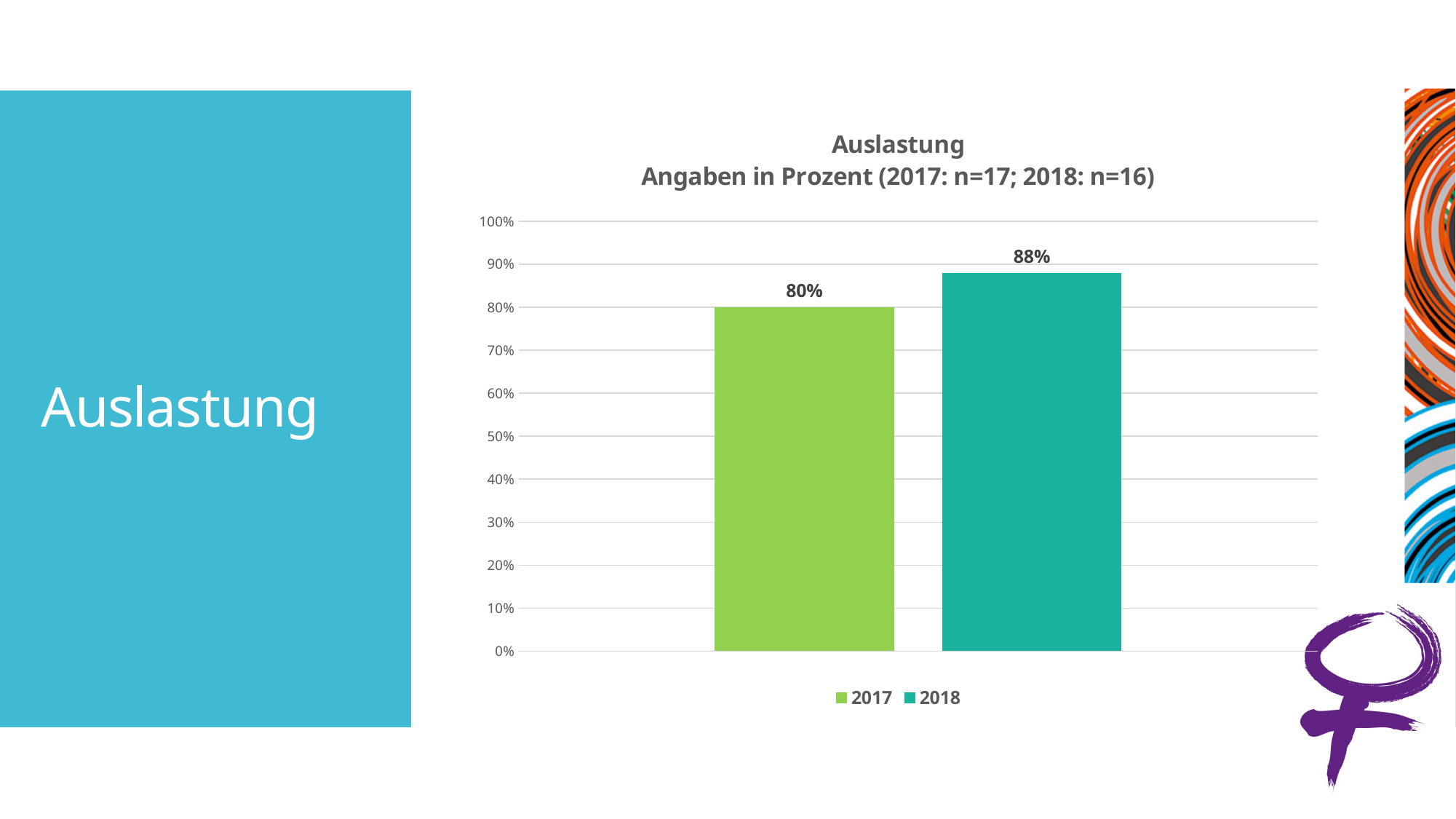
What is the difference between the 2018 and 2017 values? 8% How many bars are plotted in the chart? 2 How many series does the legend list? 2 Does the value rise or fall from 2017 to 2018? Rise Which year has the higher value? 2018 Is the value for 2018 larger than the value for 2017? Yes Is the value for 2018 greater or less than 90%? less Which year has the lower value? 2017 What is the value for 2018? 88% What is the title of the chart? Auslastung Angaben in Prozent (2017: n=17; 2018: n=16) What kind of chart is shown? Bar chart What is the value for 2017? 80%